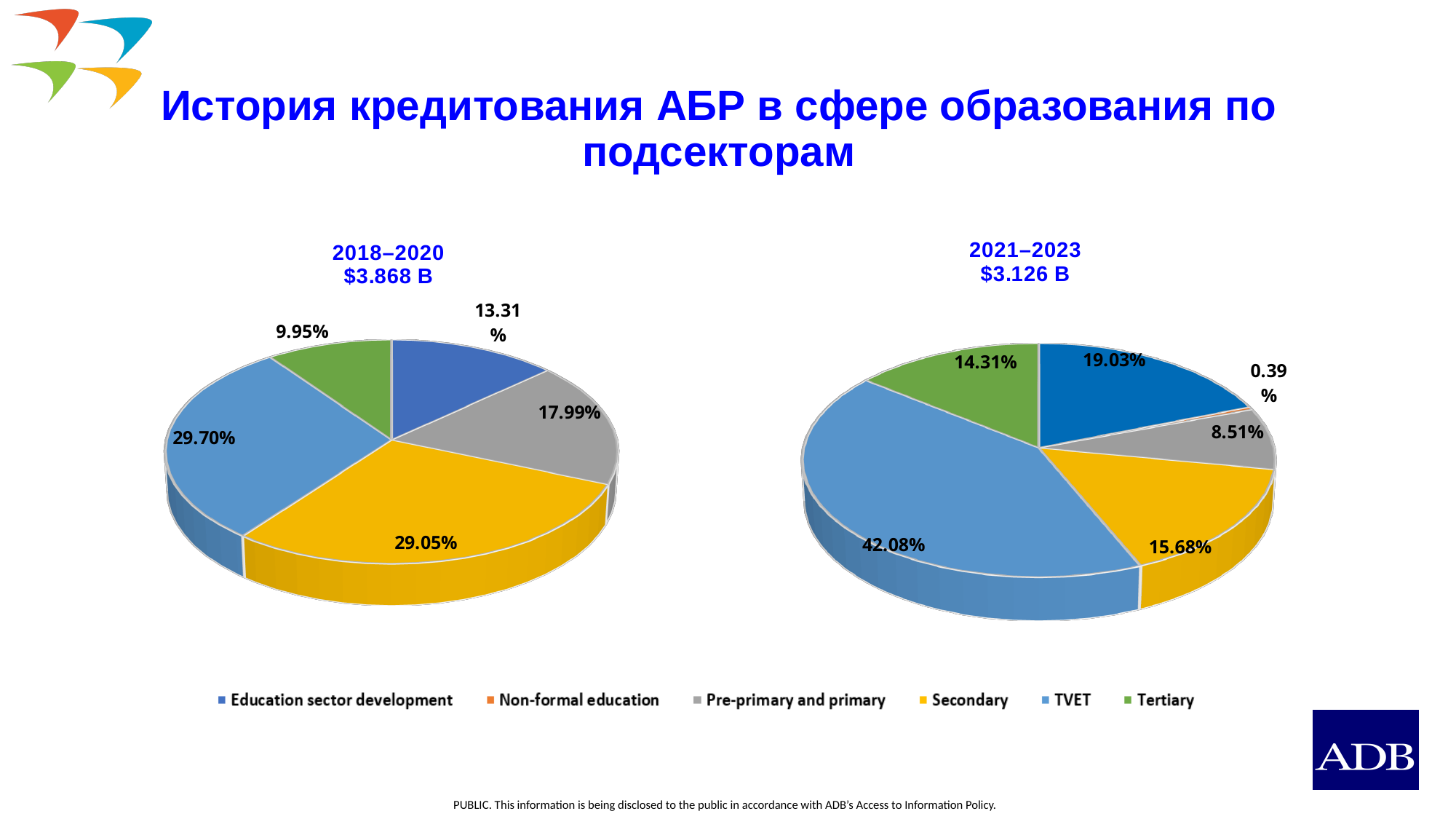
In the 2018–2020 pie chart, which subsector has the smallest share? Tertiary In the 2018–2020 pie chart, what share does TVET have? 29.70% What total amount is shown above the 2021–2023 pie chart? $3.126 B In the 2021–2023 pie chart, what share does Non-formal education have? 0.39% In the 2021–2023 pie chart, what is the difference in percentage points between TVET and Secondary? 26.40 In the 2018–2020 pie chart, which is larger: Secondary or Pre-primary and primary? Secondary In the 2021–2023 pie chart, which subsector has the largest share? TVET In the 2021–2023 pie chart, which subsector has the smallest share? Non-formal education What kind of charts are shown on the slide? Pie charts How many subsectors does the legend list? 6 In the 2021–2023 pie chart, what share does Education sector development have? 19.03% In the 2018–2020 pie chart, what share does Pre-primary and primary have? 17.99%